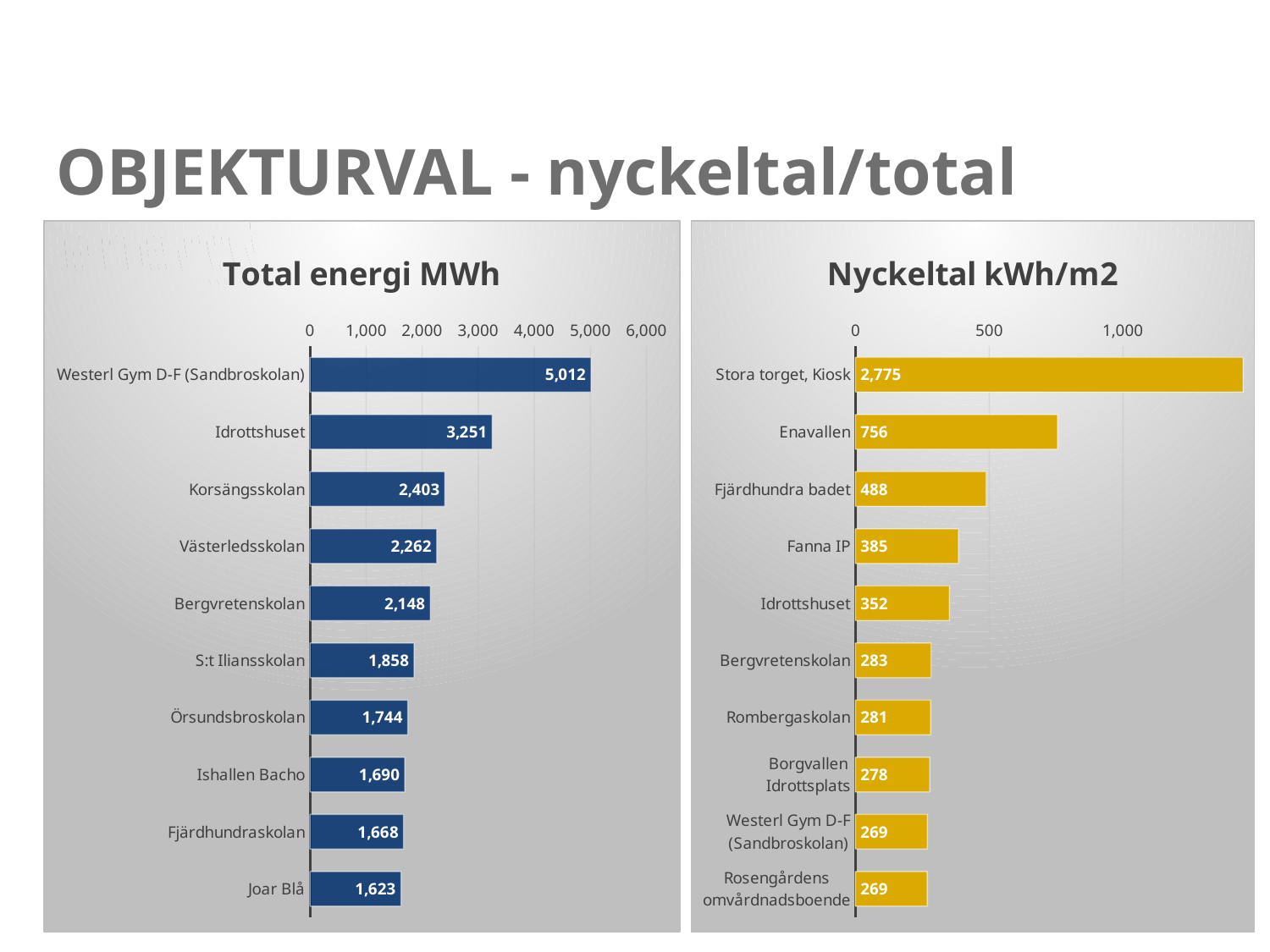
In the 'Total energi MWh' chart, which category has the lowest value? Joar Blå In the 'Total energi MWh' chart, how many categories are shown? 10 In the 'Total energi MWh' chart, what is the value for Idrottshuset? 3,251 In the 'Nyckeltal kWh/m2' chart, which category has the highest value? Stora torget, Kiosk What kind of chart is the 'Total energi MWh' chart? Bar chart In the 'Nyckeltal kWh/m2' chart, what is the difference between Stora torget, Kiosk and Enavallen? 2,019 In the 'Nyckeltal kWh/m2' chart, which is larger, Enavallen or Fanna IP? Enavallen In the 'Total energi MWh' chart, which category has the highest value? Westerl Gym D-F (Sandbroskolan) In the 'Nyckeltal kWh/m2' chart, what is the value for Fjärdhundra badet? 488 In the 'Total energi MWh' chart, what is the difference between Westerl Gym D-F (Sandbroskolan) and Idrottshuset? 1,761 What is the title of the chart on the right side of the slide? Nyckeltal kWh/m2 In the 'Nyckeltal kWh/m2' chart, is the value for Idrottshuset greater or less than 500? less